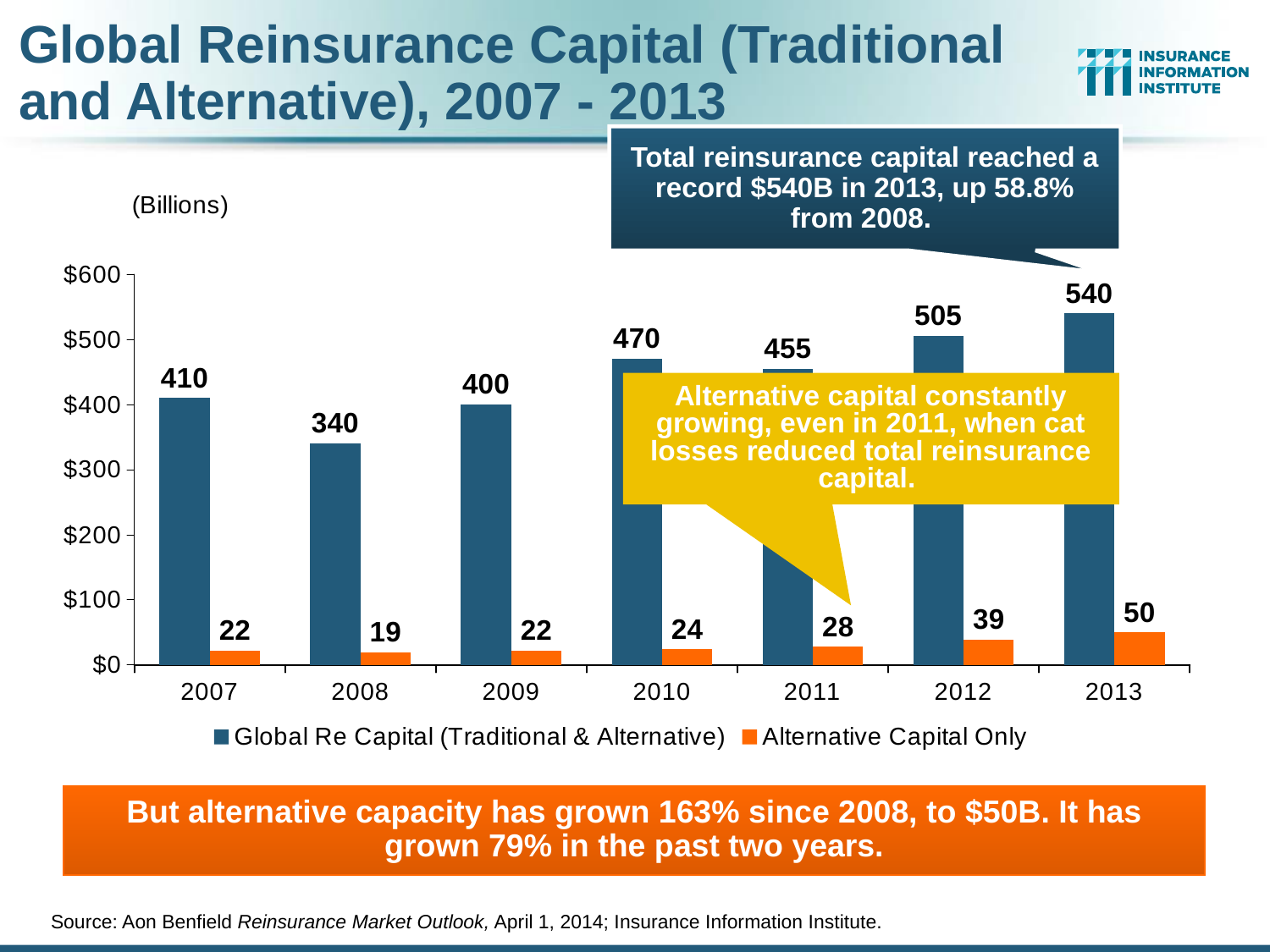
Does Alternative Capital Only rise or fall from 2008 to 2013? Rise Which year has the lowest Alternative Capital Only value? 2008 How many series does the legend list? 2 What is the difference between Alternative Capital Only in 2013 and in 2011? 22 How many years are shown on the x axis? 7 What is the difference between Global Re Capital (Traditional & Alternative) in 2013 and in 2008? 200 What is the value of Alternative Capital Only for 2012? 39 Which year has the highest Global Re Capital (Traditional & Alternative)? 2013 What is the value of Global Re Capital (Traditional & Alternative) for 2010? 470 Is the Global Re Capital (Traditional & Alternative) value for 2012 greater or less than $400? greater What kind of chart is shown on the slide? Bar chart Which is larger: Global Re Capital (Traditional & Alternative) in 2010 or in 2011? 2010